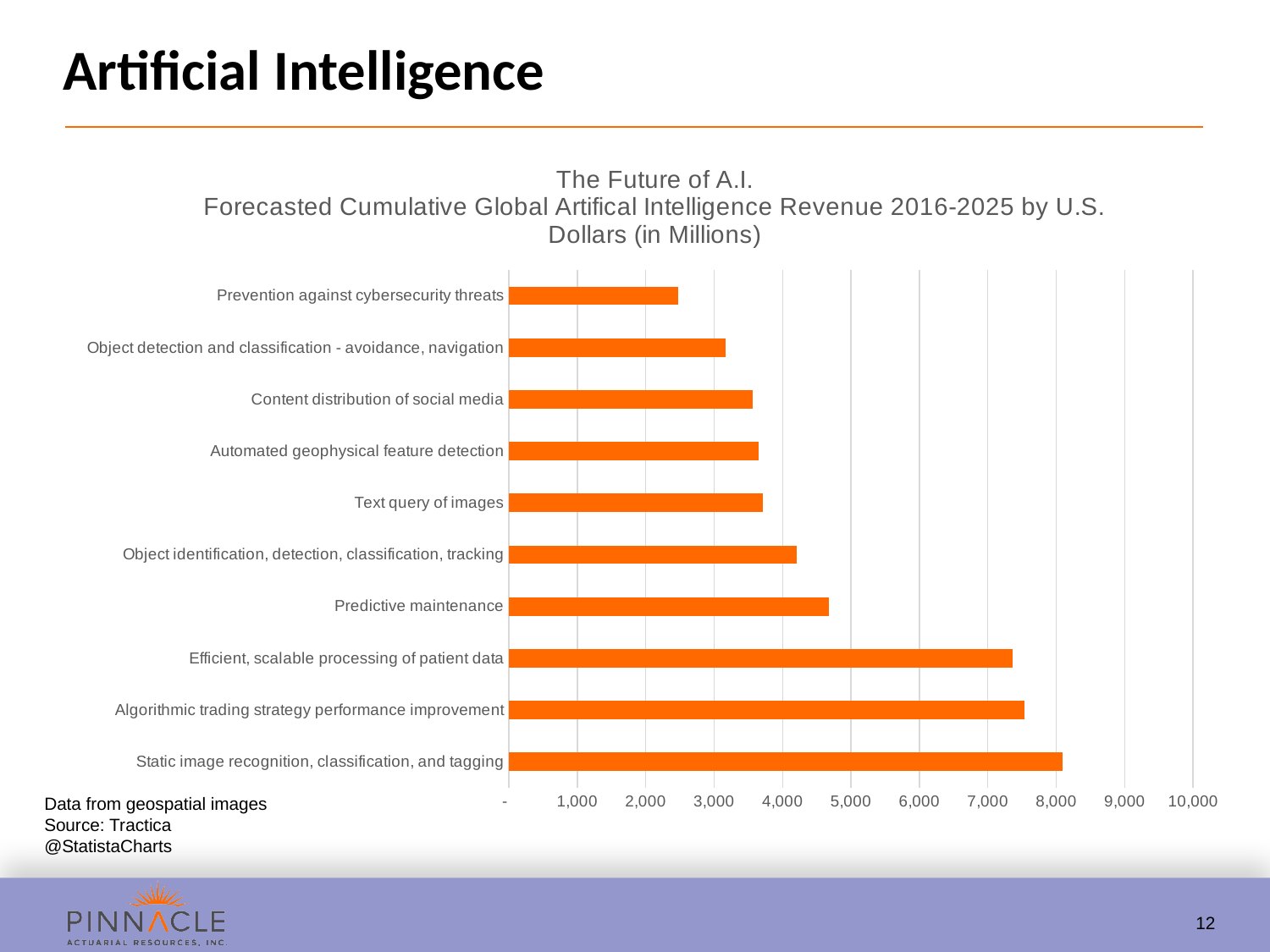
How many categories are plotted in the chart? 10 Is the value for Predictive maintenance greater or less than 4,000? greater Which is larger: the value for Object identification, detection, classification, tracking or the value for Object detection and classification - avoidance, navigation? Object identification, detection, classification, tracking What colour are the bars in the chart? orange Which category has the highest forecasted cumulative revenue? Static image recognition, classification, and tagging Which category has the lowest forecasted cumulative revenue? Prevention against cybersecurity threats Which is larger: the value for Predictive maintenance or the value for Text query of images? Predictive maintenance Is the value for Prevention against cybersecurity threats greater or less than 3,000? less Is the value for Content distribution of social media greater or less than 4,000? less What kind of chart is shown on the slide? bar chart